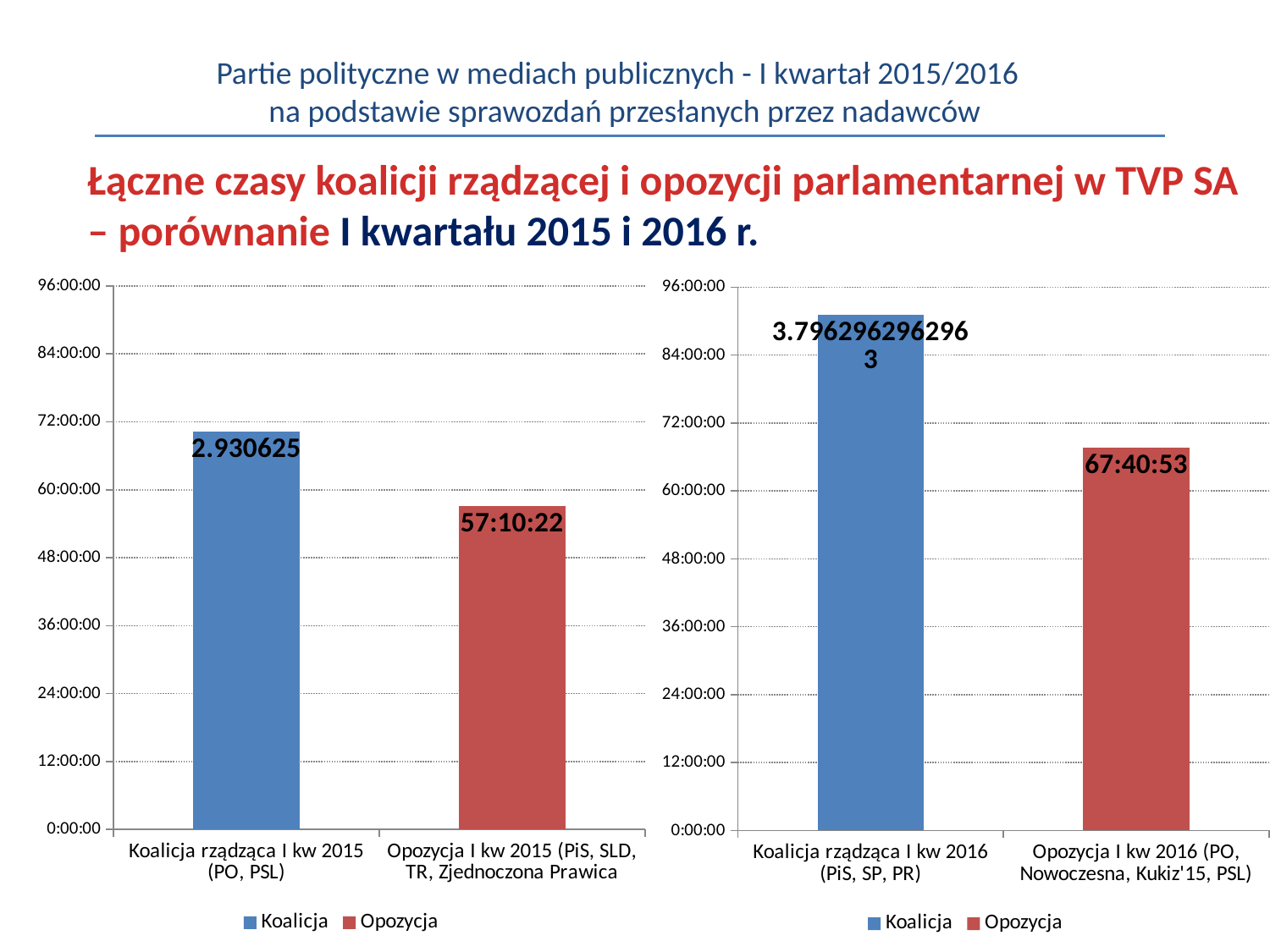
In the left chart (I kw 2015), is the value for Koalicja rządząca I kw 2015 (PO, PSL) greater or less than 60:00:00? greater Which is larger: the Opozycja value in the left chart (I kw 2015) or the Opozycja value in the right chart (I kw 2016)? Opozycja I kw 2016 (67:40:53) What type of chart is used on this slide? Bar chart What are the two legend entries shown under each chart? Koalicja and Opozycja In the right chart (I kw 2016), which category has the lower bar? Opozycja I kw 2016 (PO, Nowoczesna, Kukiz'15, PSL) In the left chart (I kw 2015), what value is shown for Opozycja I kw 2015 (PiS, SLD, TR, Zjednoczona Prawica)? 57:10:22 In the left chart (I kw 2015), what data label is printed on the Koalicja rządząca I kw 2015 (PO, PSL) bar? 2.930625 How many series does the legend of the left chart (I kw 2015) list? 2 In the right chart (I kw 2016), what value is shown for Opozycja I kw 2016 (PO, Nowoczesna, Kukiz'15, PSL)? 67:40:53 In the left chart (I kw 2015), which category has the higher bar? Koalicja rządząca I kw 2015 (PO, PSL) In the right chart (I kw 2016), is the value for Koalicja rządząca I kw 2016 (PiS, SP, PR) greater or less than 84:00:00? greater How many bars are plotted in the right chart (I kw 2016)? 2